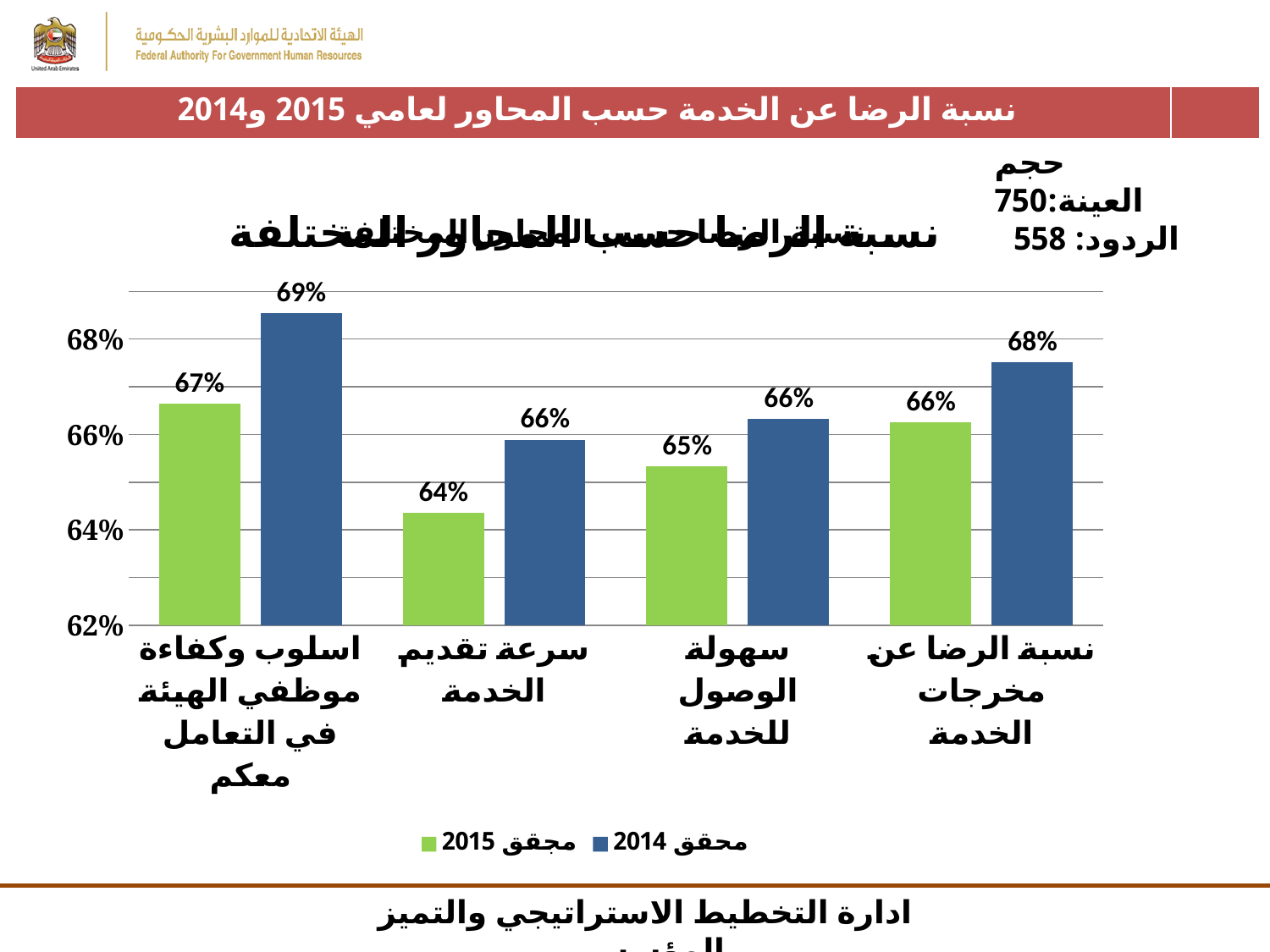
For سهولة الوصول للخدمة, which is larger: the 2014 value or the 2015 value? 2014 How many series does the legend list? 2 What is the 2014 (محقق 2014) value for اسلوب وكفاءة موظفي الهيئة في التعامل معكم? 69% What is the 2014 (محقق 2014) value for نسبة الرضا عن مخرجات الخدمة? 68% What kind of chart is shown on the slide? bar chart Which category has the lowest 2015 (محقق 2015) value? سرعة تقديم الخدمة What is the difference between the 2014 and 2015 values for سرعة تقديم الخدمة? 2% How many categories are shown on the x axis? 4 What is the 2015 (محقق 2015) value for سرعة تقديم الخدمة? 64% Which category has the highest 2014 (محقق 2014) value? اسلوب وكفاءة موظفي الهيئة في التعامل معكم Which colour represents محقق 2015 in the legend? green What is the 2015 (محقق 2015) value for سهولة الوصول للخدمة? 65%